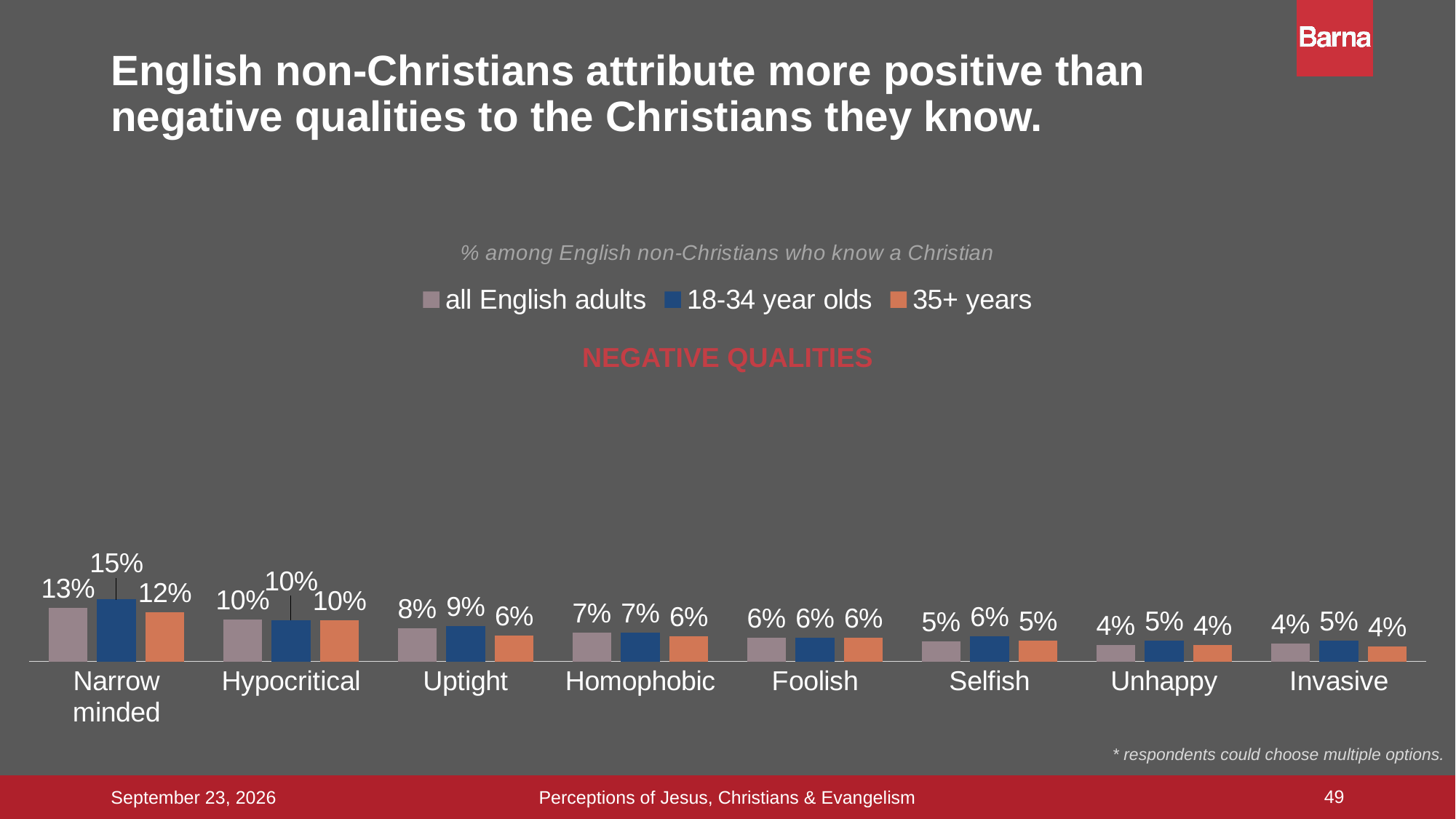
What is the difference between the 18-34 year olds and 35+ years values for 'Narrow minded'? 3 percentage points Which negative quality has the highest value among all English adults? Narrow minded Do the values for all English adults rise or fall moving from left to right along the x axis? Fall Which negative quality has the lowest value among 18-34 year olds? Unhappy and Invasive (both 5%) What percentage of 18-34 year olds attribute the quality 'Narrow minded' to the Christians they know? 15% For 'Uptight', which is larger: the value for 18-34 year olds or for 35+ years? 18-34 year olds Which colour represents the '35+ years' series in the legend? Orange How many series does the legend list? 3 What kind of chart is shown on the slide? Bar chart How many negative qualities are shown on the x axis? 8 What is the value for all English adults for 'Hypocritical'? 10% What is the value for 35+ years for 'Uptight'? 6%